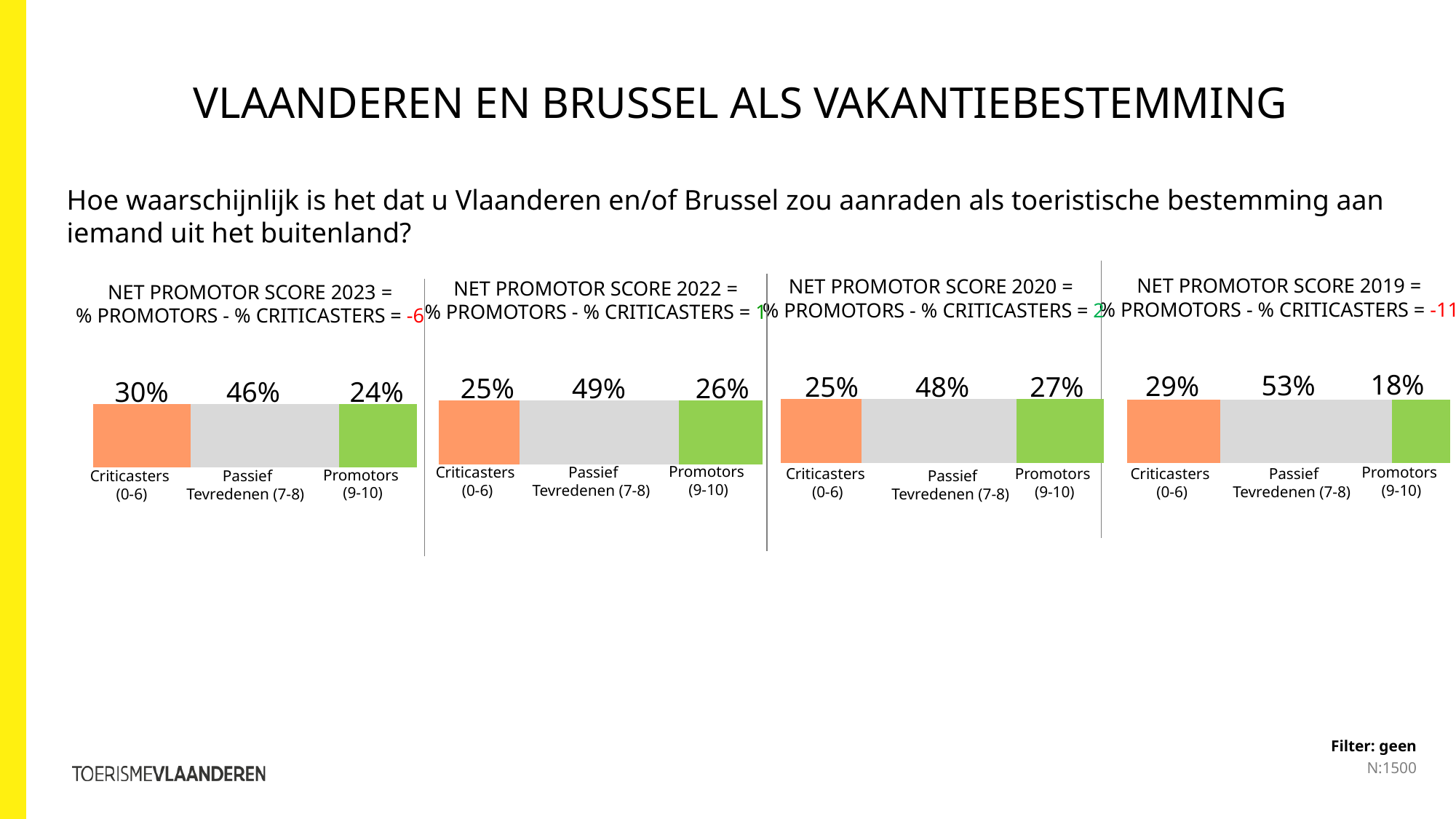
In the Net Promotor Score 2023 chart, which category has the lowest value? Promotors (9-10) How many categories does the Net Promotor Score 2020 chart show? 3 In the Net Promotor Score 2020 chart, what is the value for Promotors (9-10)? 27% In the Net Promotor Score 2019 chart, what is the difference between Passief Tevredenen (7-8) and Criticasters (0-6)? 24% In the Net Promotor Score 2023 chart, what is the difference between Criticasters (0-6) and Promotors (9-10)? 6% In the Net Promotor Score 2022 chart, what is the value for Passief Tevredenen (7-8)? 49% In the Net Promotor Score 2019 chart, what is the value for Promotors (9-10)? 18% In the Net Promotor Score 2019 chart, which category has the highest value? Passief Tevredenen (7-8) What kind of chart is the Net Promotor Score 2022 chart? Stacked bar chart In the Net Promotor Score 2023 chart, what is the value for Criticasters (0-6)? 30% What is the Net Promotor Score shown in the title of the 2019 chart? -11 In the Net Promotor Score 2022 chart, which is larger: Criticasters (0-6) or Promotors (9-10)? Promotors (9-10)